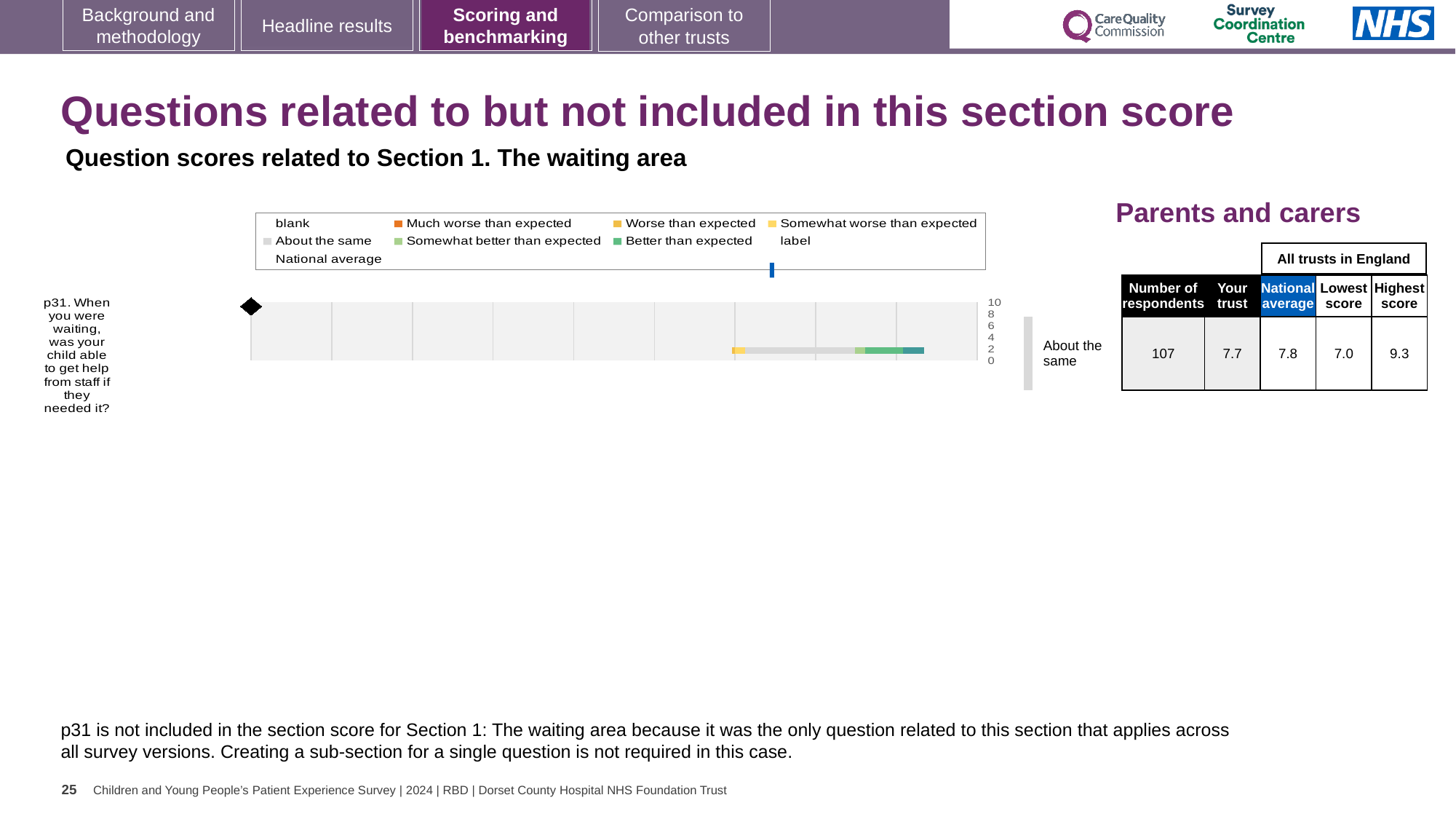
What colour does the legend use for 'Much worse than expected'? Orange For p31, which is larger: the 'Your trust' score or the national average? National average In the table next to the chart, what is the national average score for p31? 7.8 What kind of chart is shown for question p31? bar chart How many respondents answered question p31? 107 In the table next to the chart, what is the 'Your trust' score for p31? 7.7 How many survey questions are plotted in the chart? 1 In the table next to the chart, what is the highest score across all trusts in England for p31? 9.3 What is the difference between the highest score and the lowest score for p31? 2.3 What is the difference between the national average and the 'Your trust' score for p31? 0.1 In the table next to the chart, what is the lowest score across all trusts in England for p31? 7.0 What benchmark category label is shown to the right of the p31 bar? About the same